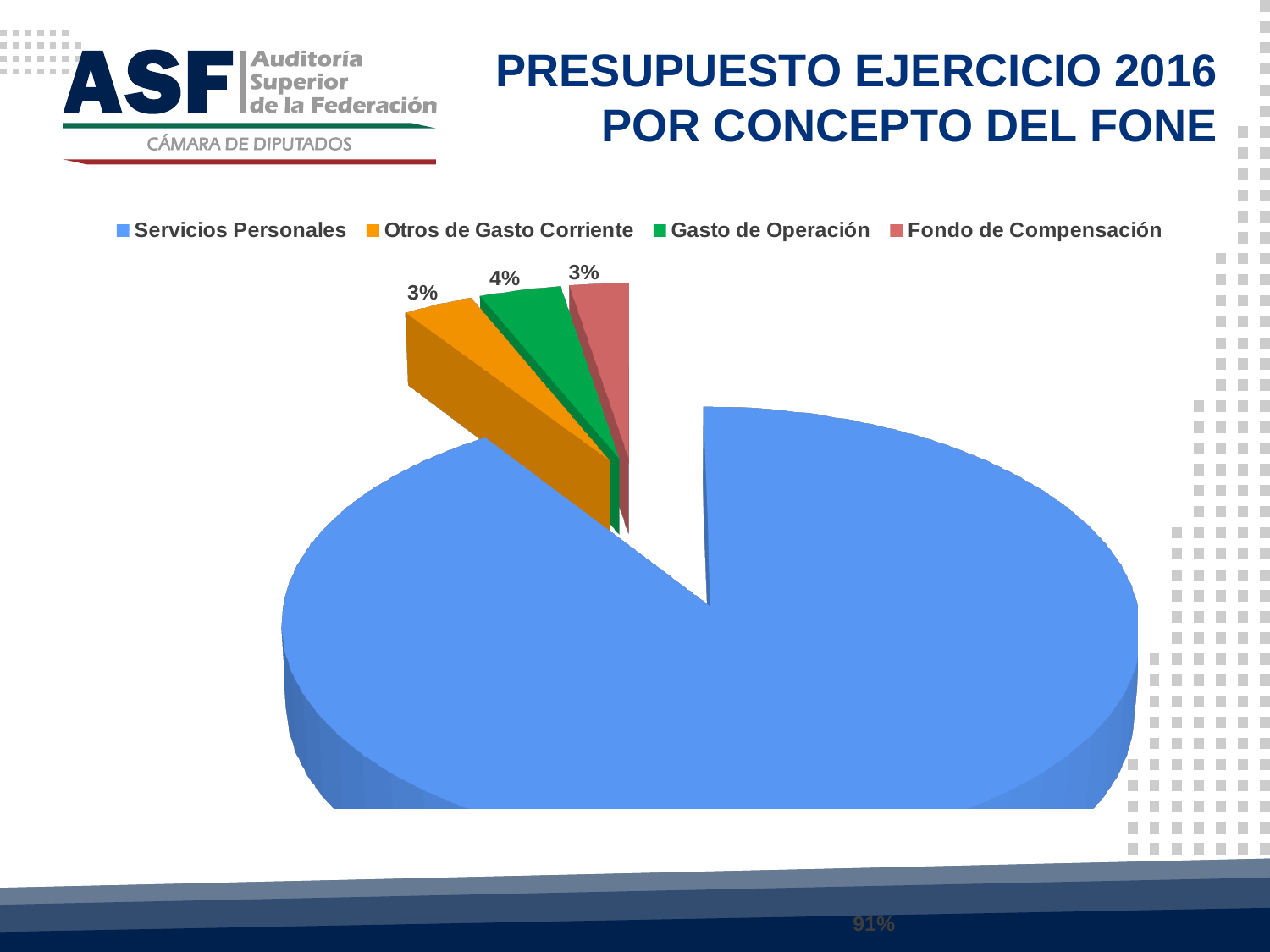
What is the difference in percentage points between Gasto de Operación and Fondo de Compensación? 1% How many slices does the pie chart have? 4 What percentage is shown for Servicios Personales? 91% What percentage is shown for Otros de Gasto Corriente? 3% What percentage is shown for Fondo de Compensación? 3% What colour is the Servicios Personales slice? blue What percentage is shown for Gasto de Operación? 4% Which category has the largest share of the pie? Servicios Personales How many entries does the legend list? 4 What is the title of the slide containing the chart? PRESUPUESTO EJERCICIO 2016 POR CONCEPTO DEL FONE What kind of chart is shown on the slide? pie chart Which is larger, Gasto de Operación or Otros de Gasto Corriente? Gasto de Operación